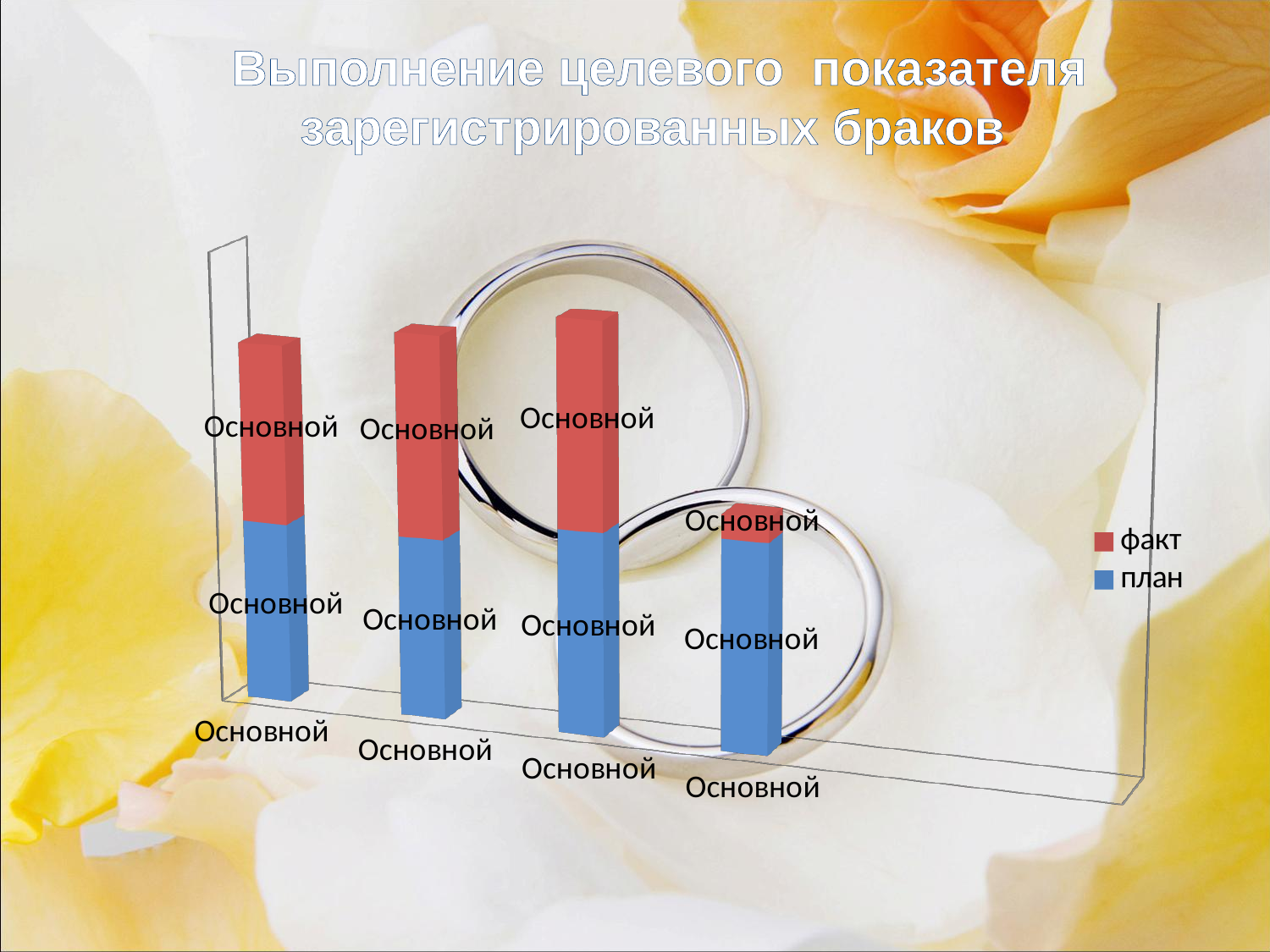
Which bar has the smallest факт (red) segment? the fourth (rightmost) bar What is the title of the chart on the slide? Выполнение целевого показателя зарегистрированных браков How many series does the legend list? 2 What kind of chart is shown on the slide? bar chart Which bar, counting from the left, is the shortest overall? the fourth (rightmost) bar What are the two series named in the legend? факт and план Which bar has the largest факт (red) segment? the third bar Which bar, counting from the left, is the tallest overall? the third bar How many stacked bars are plotted in the chart? 4 In the rightmost bar, which segment is larger, план or факт? план